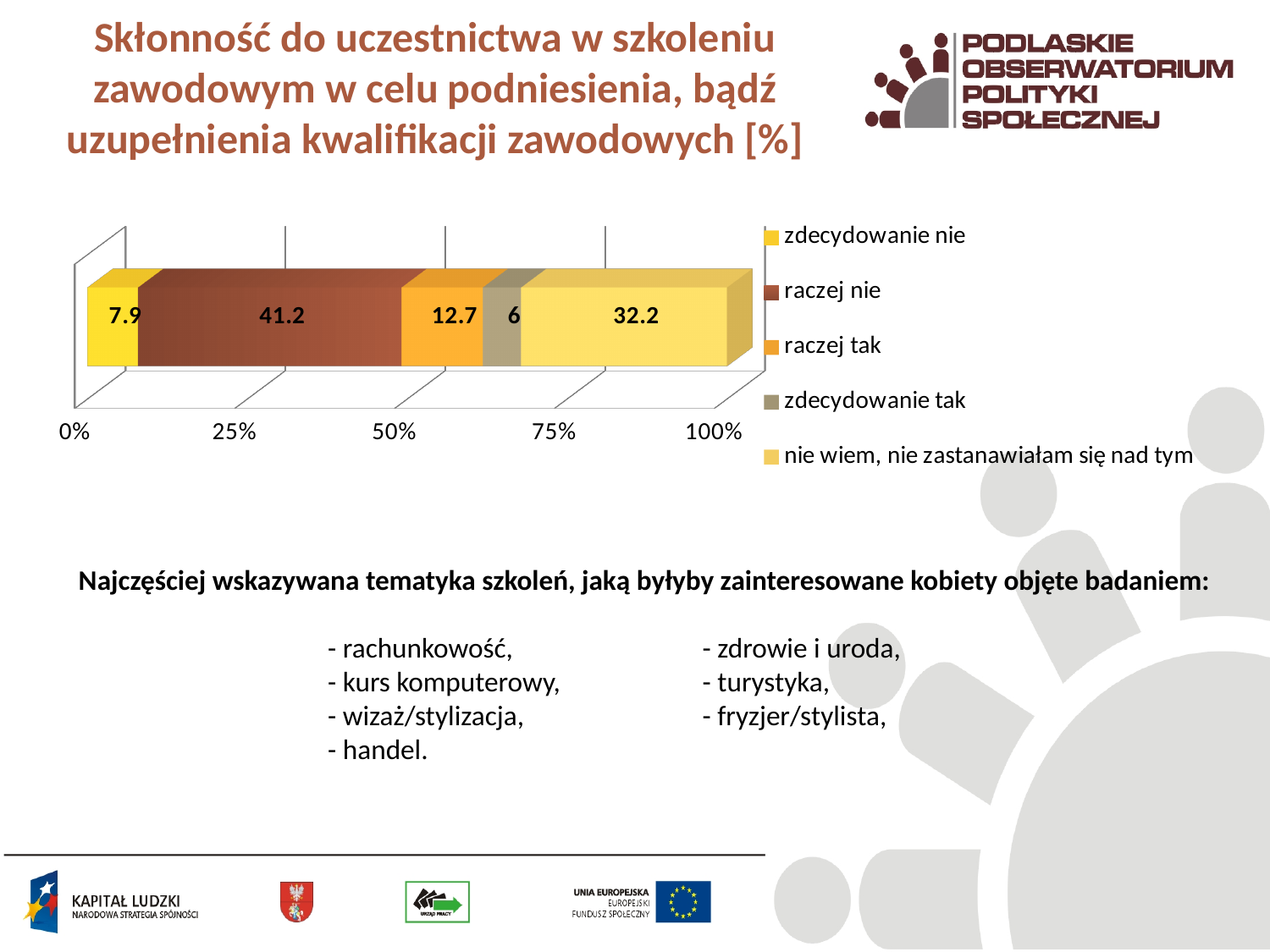
What is the difference between the values for "raczej nie" and "raczej tak"? 28.5 What is the value for "zdecydowanie nie"? 7.9 What is the value for "zdecydowanie tak"? 6 What is the total of all segments in the stacked bar? 100 Which response category has the lowest value? zdecydowanie tak What kind of chart is shown on the slide? stacked bar chart What is the value for "nie wiem, nie zastanawiałam się nad tym"? 32.2 How many series does the legend list? 5 Which is larger, the value for "raczej tak" or the value for "zdecydowanie nie"? raczej tak What is the value for "raczej nie"? 41.2 Which response category has the highest value? raczej nie Which legend entry is shown in the dark red colour? raczej nie